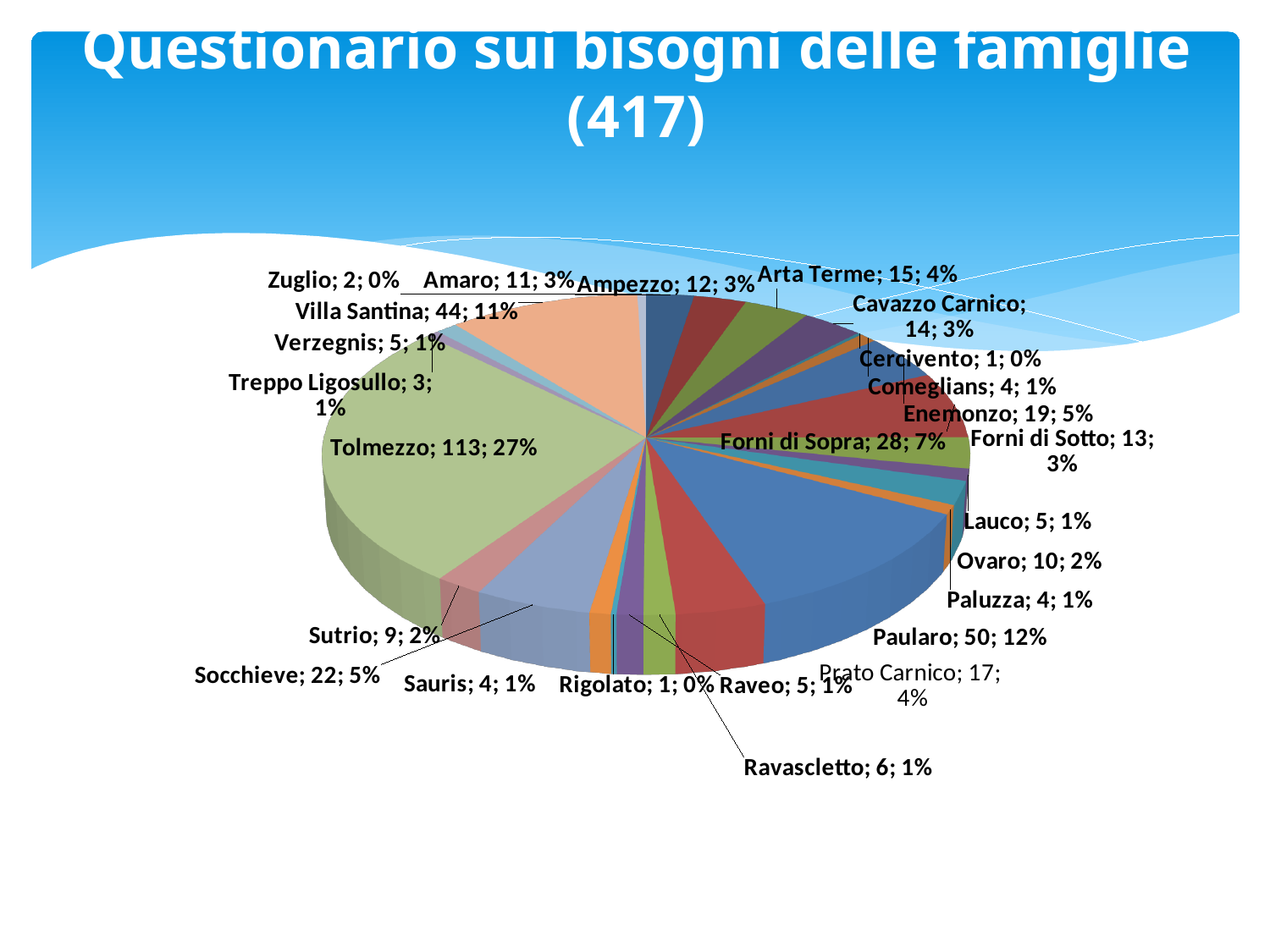
What is the value shown for Paularo? 50 What share of the pie does Tolmezzo represent? 27% What is the value shown for Forni di Sopra? 28 What is the title of the chart? Questionario sui bisogni delle famiglie (417) How many municipalities (slices) are shown in the pie chart? 25 Which municipality has the largest slice of the pie? Tolmezzo What percentage is shown for Villa Santina? 11% Which has a larger value, Socchieve or Enemonzo? Socchieve How many questionnaires are attributed to Tolmezzo? 113 What is the difference between the values for Paularo and Villa Santina? 6 What type of chart is shown on the slide? pie chart What is the value shown for Prato Carnico? 17